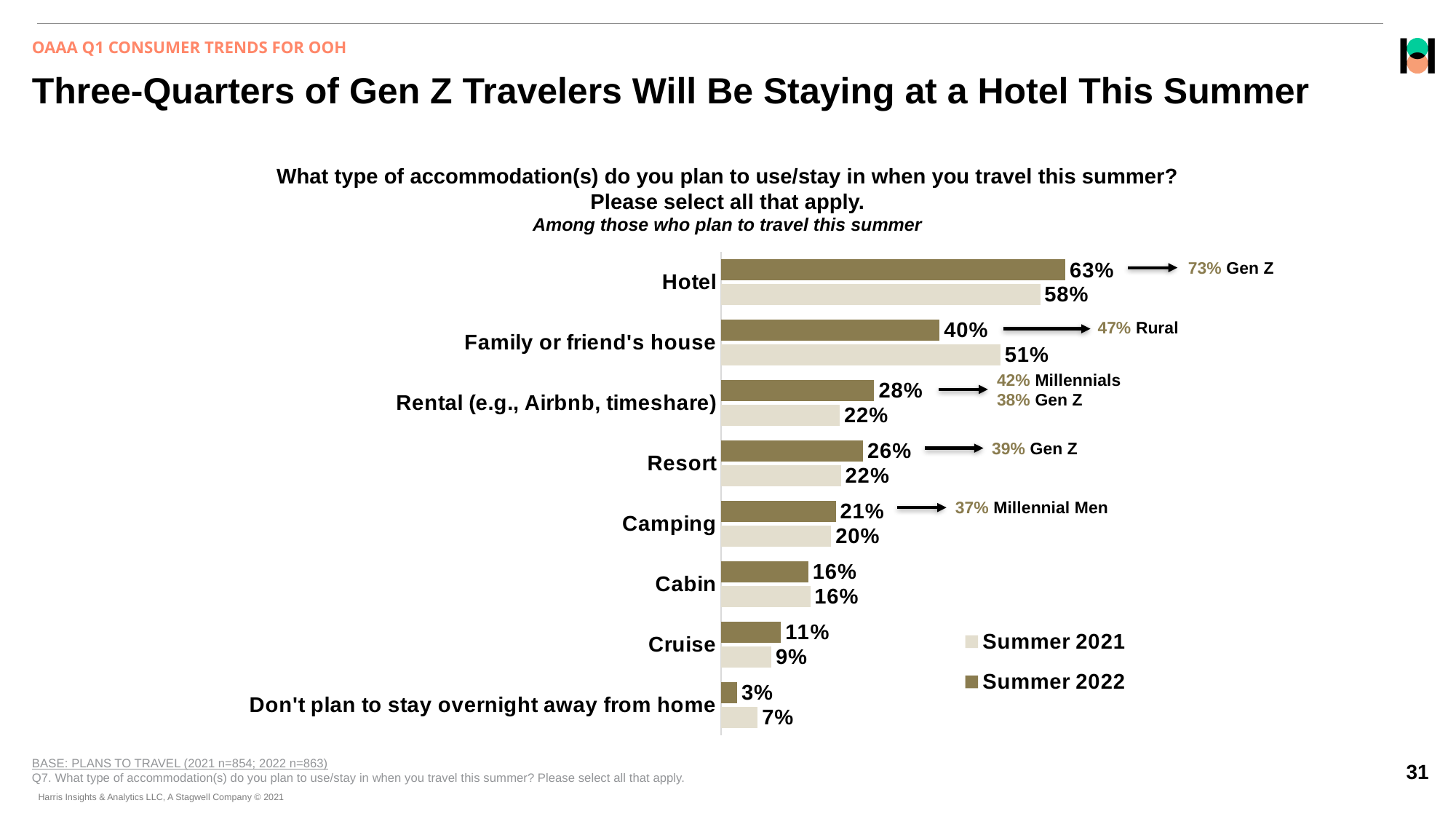
What is the Summer 2021 value for Family or friend's house? 51% Which category has the highest Summer 2022 value? Hotel What is the difference between the Summer 2021 and Summer 2022 values for Family or friend's house? 11% What is the Summer 2022 value for Rental (e.g., Airbnb, timeshare)? 28% What percentage of Gen Z is annotated next to the Hotel bar? 73% Which category has the lowest Summer 2022 value? Don't plan to stay overnight away from home How many accommodation categories are shown in the chart? 8 How many series does the legend list? 2 What kind of chart is shown on the slide? Bar chart What is the Summer 2022 value for Hotel? 63% Which is larger for Cruise: the Summer 2021 value or the Summer 2022 value? Summer 2022 What is the Summer 2022 value for Camping? 21%